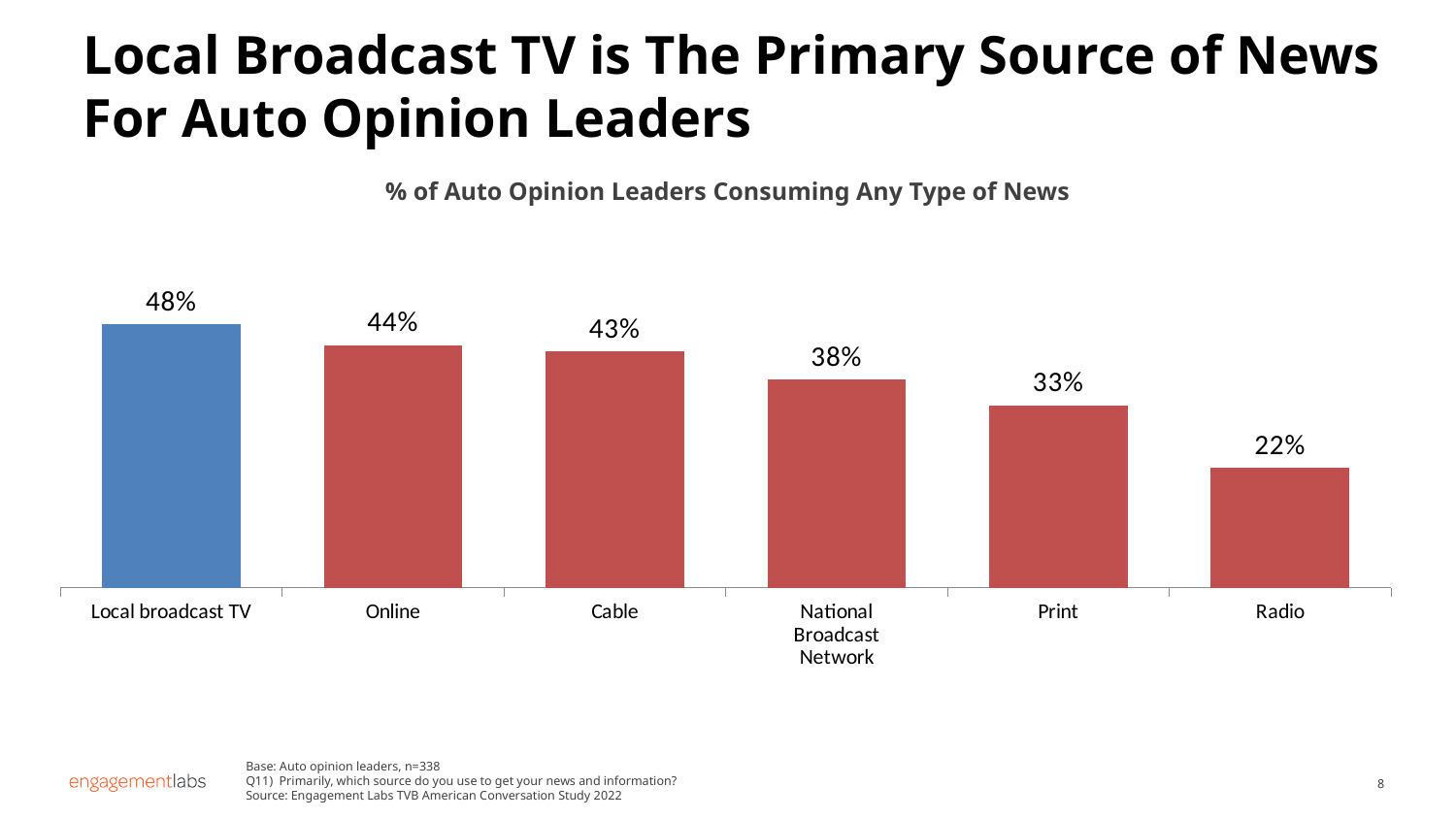
What is the value shown for National Broadcast Network? 38% Which is larger, the value for Online or the value for Print? Online Which news source has the lowest percentage? Radio What is the difference in percentage points between Local broadcast TV and Radio? 26 Which news source has the highest percentage? Local broadcast TV How many news sources are shown in the chart? 6 What percentage of auto opinion leaders consume news via Local broadcast TV? 48% Do the values rise or fall moving from left to right across the chart? Fall What is the value shown for Online? 44% What is the value shown for Radio? 22% What type of chart is shown on the slide? Bar chart What is the difference in percentage points between Cable and Print? 10